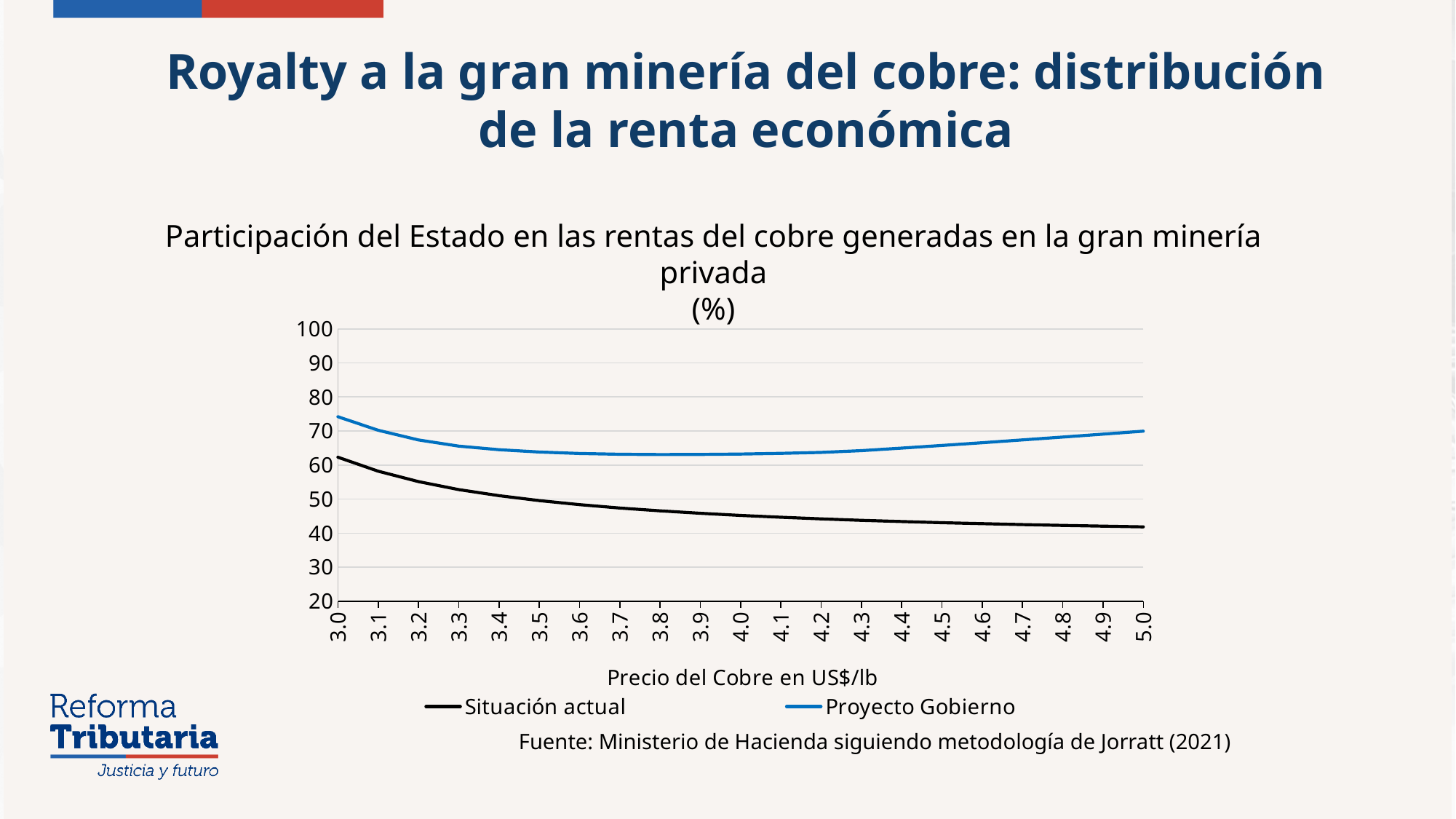
What is the label of the x axis? Precio del Cobre en US$/lb How many series does the legend list? 2 At a copper price of 4.0, which series has the higher value, Situación actual or Proyecto Gobierno? Proyecto Gobierno Is the value for Proyecto Gobierno at a copper price of 4.0 greater or less than 70? less Which series has the higher value at a copper price of 5.0? Proyecto Gobierno How many copper price points are marked along the x axis? 21 Is the value for Proyecto Gobierno at a copper price of 3.0 greater or less than 80? less Does the Situación actual line rise or fall as the copper price increases from 3.0 to 5.0? Fall What are the two series named in the legend? Situación actual and Proyecto Gobierno Is the value for Situación actual at a copper price of 3.0 greater or less than 50? greater What kind of chart is shown on the slide? Line chart